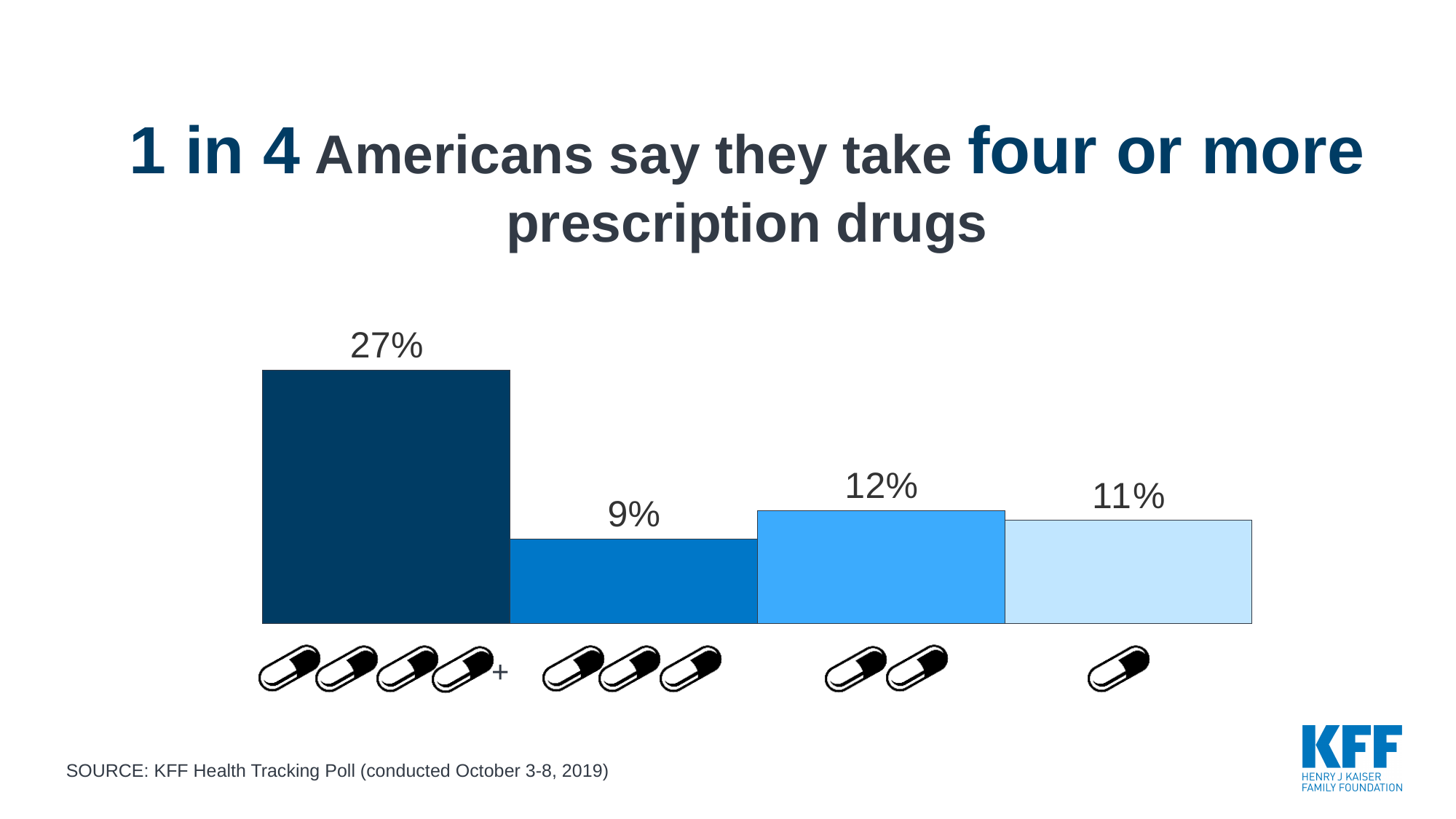
What percentage is shown for the bar above the single pill icon? 11% What source is cited for the chart? KFF Health Tracking Poll (conducted October 3-8, 2019) How many bars are in the chart? 4 What is the difference between the four-or-more bar (27%) and the three-pill bar (9%)? 18 percentage points Which category has the highest bar? Four or more prescription drugs (27%) What percentage is shown for the bar above the three pill icons? 9% What percentage is shown for the bar above the two pill icons? 12% What is the difference between the two-pill bar (12%) and the one-pill bar (11%)? 1 percentage point Which category has the lowest bar? Three prescription drugs (9%) Which is larger, the value for two pills or the value for one pill? Two pills (12%) What kind of chart is shown on the slide? Bar chart What percentage of Americans say they take four or more prescription drugs (the bar above the four pills with a plus sign)? 27%